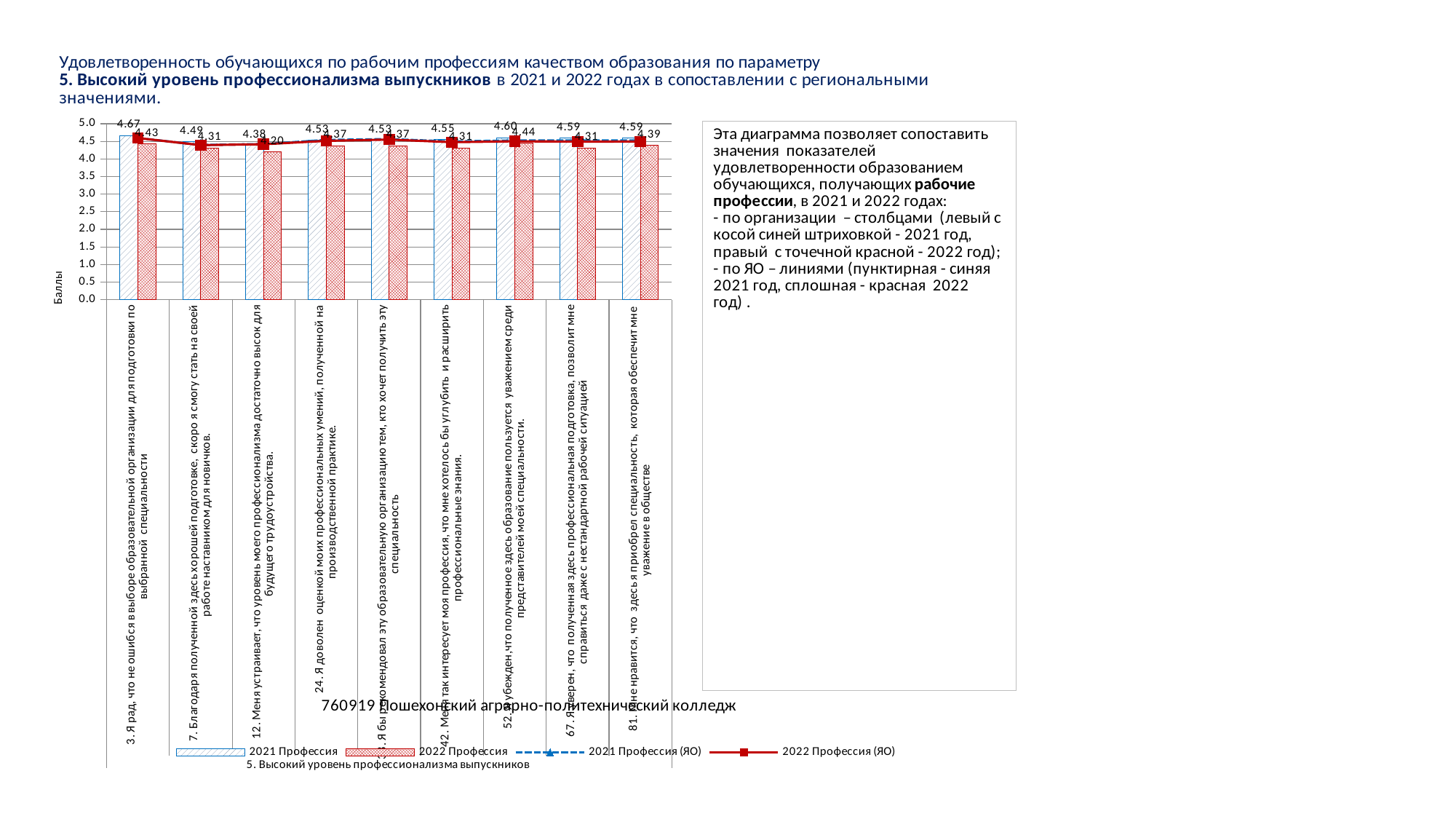
For statement 7 (Благодаря полученной здесь хорошей подготовке...), which is larger: the 2021 Профессия value or the 2022 Профессия value? 2021 Профессия Which statement has the lowest 2022 Профессия value? 12. Меня устраивает, что уровень моего профессионализма достаточно высок для будущего трудоустройства What is the label of the vertical axis? Баллы What kind of chart is shown on the slide? A combined bar and line chart How many series does the chart legend list? 4 Which statement has the highest 2021 Профессия value? 3. Я рад, что не ошибся в выборе образовательной организации для подготовки по выбранной специальности What is the difference between the 2021 Профессия and 2022 Профессия values for statement 3? 0.24 How many categories (statements) are plotted along the x axis? 9 What is the 2022 Профессия value for statement 52 (Я убежден, что полученное здесь образование пользуется уважением...)? 4.44 What is the 2022 Профессия value for statement 12 (Меня устраивает, что уровень моего профессионализма достаточно высок...)? 4.20 Which statement has the lowest 2021 Профессия value? 12. Меня устраивает, что уровень моего профессионализма достаточно высок для будущего трудоустройства What is the 2021 Профессия value for statement 3 (Я рад, что не ошибся в выборе образовательной организации...)? 4.67